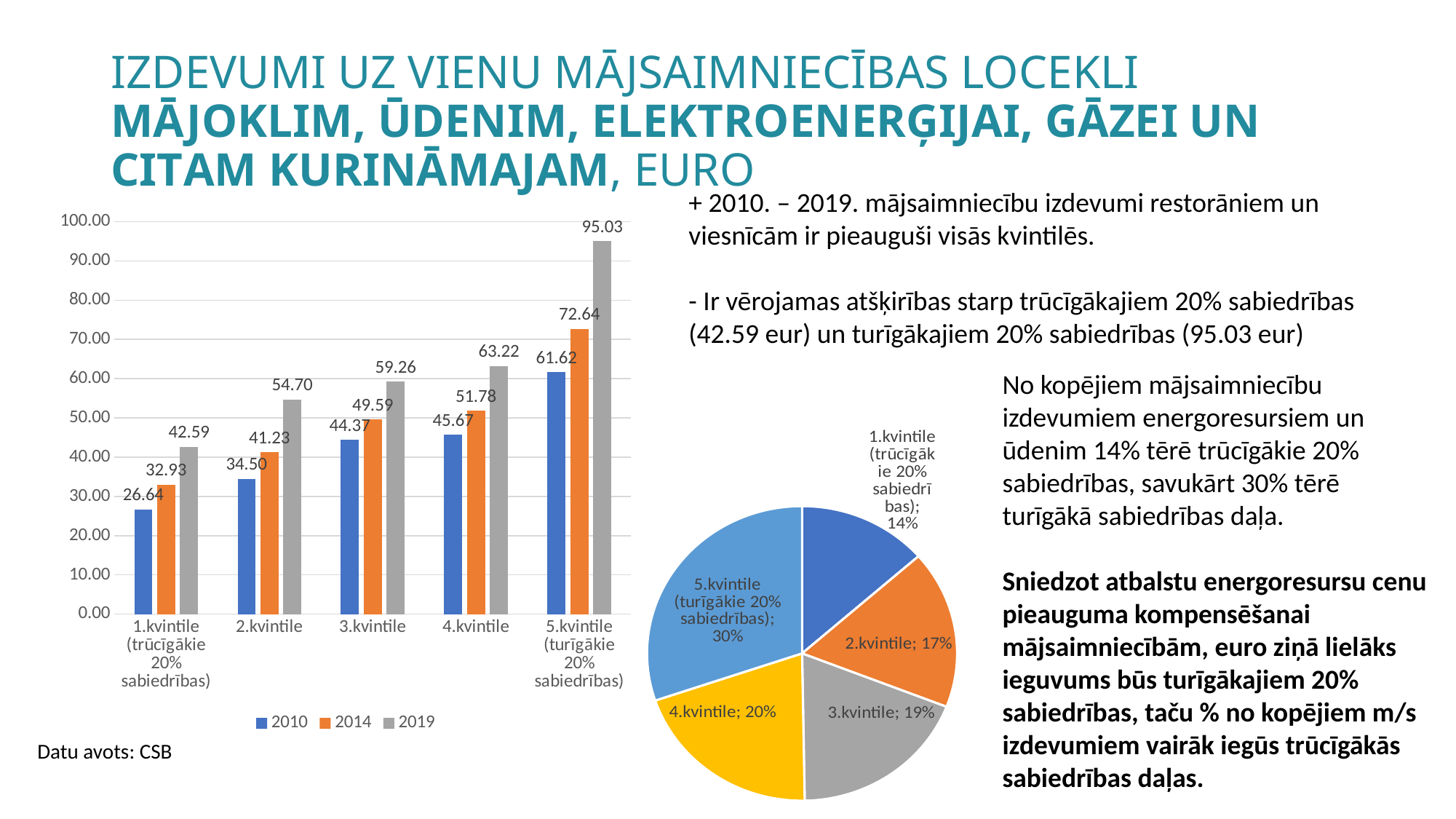
In the pie chart on the right, what share does 5.kvintile have? 30% In the bar chart on the left, which is larger: the 2014 value for 4.kvintile or the 2019 value for 2.kvintile? 2019 value for 2.kvintile In the bar chart on the left, which category has the highest 2019 value? 5.kvintile In the bar chart on the left, what is the difference between the 2019 values for 5.kvintile and 1.kvintile? 52.44 In the pie chart on the right, which slice is the smallest? 1.kvintile In the bar chart on the left, what is the 2019 value for 5.kvintile? 95.03 In the bar chart on the left, do the 2019 values rise or fall from 1.kvintile to 5.kvintile? rise In the bar chart on the left, what is the 2014 value for 3.kvintile? 49.59 In the bar chart on the left, what is the 2010 value for 1.kvintile? 26.64 In the bar chart on the left, which category has the lowest 2010 value? 1.kvintile In the bar chart on the left, how many series does the legend list? 3 In the pie chart on the right, how many slices are there? 5